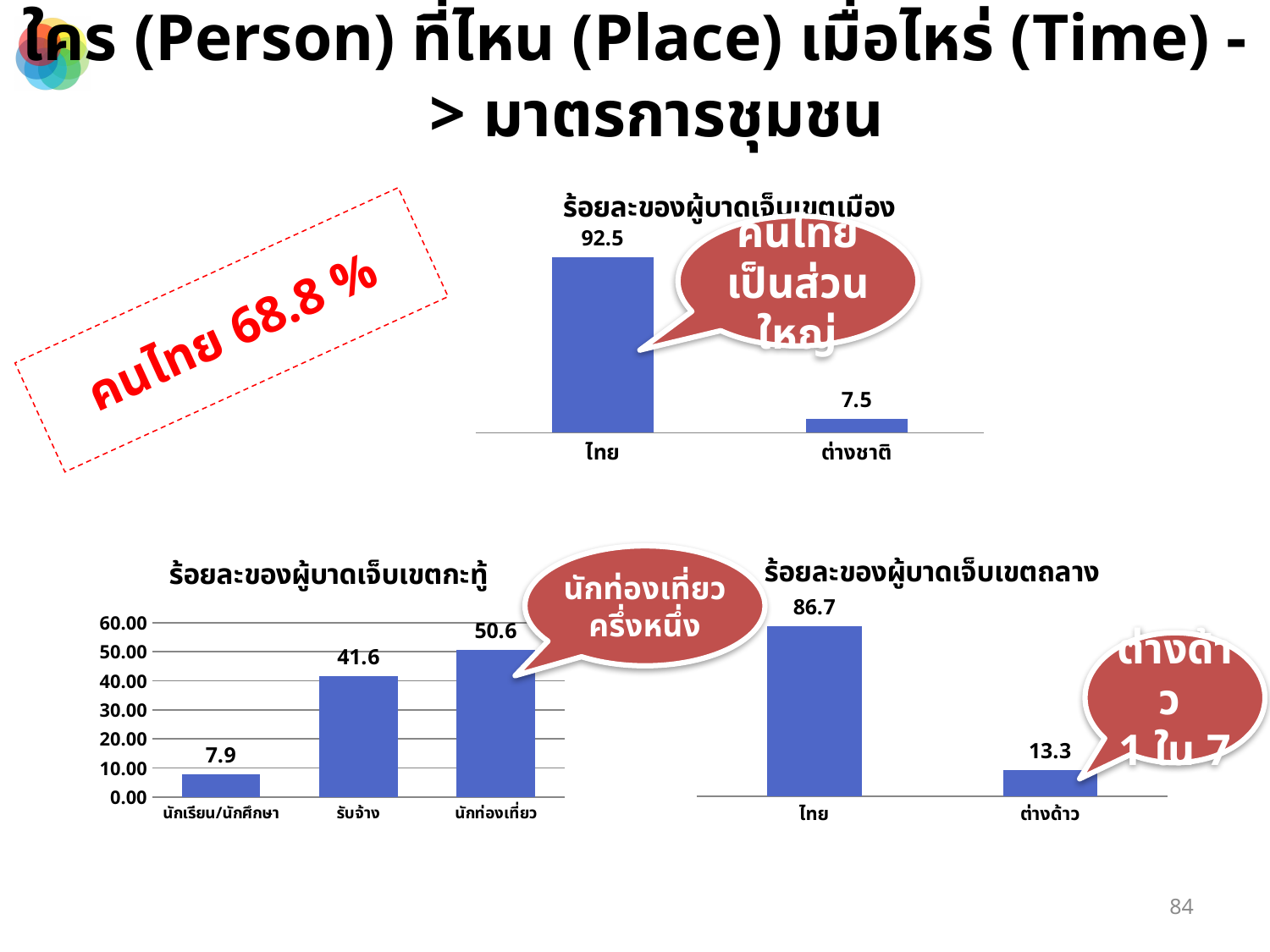
In the top chart (ร้อยละของผู้บาดเจ็บเขตเมือง), what is the value for ไทย? 92.5 In the bottom-left chart (ร้อยละของผู้บาดเจ็บเขตกะทู้), what is the difference between the values for นักท่องเที่ยว and รับจ้าง? 9.0 In the bottom-left chart (ร้อยละของผู้บาดเจ็บเขตกะทู้), which category has the lowest value? นักเรียน/นักศึกษา In the top chart (ร้อยละของผู้บาดเจ็บเขตเมือง), what is the difference between the values for ไทย and ต่างชาติ? 85.0 In the bottom-left chart (ร้อยละของผู้บาดเจ็บเขตกะทู้), what is the value for รับจ้าง? 41.6 In the bottom-right chart (ร้อยละของผู้บาดเจ็บเขตถลาง), which is larger, the value for ไทย or ต่างด้าว? ไทย How many charts are shown on the slide? 3 In the bottom-right chart (ร้อยละของผู้บาดเจ็บเขตถลาง), what is the value for ต่างด้าว? 13.3 What kind of chart is the bottom-right chart (ร้อยละของผู้บาดเจ็บเขตถลาง)? Bar chart In the bottom-left chart (ร้อยละของผู้บาดเจ็บเขตกะทู้), which category has the highest value? นักท่องเที่ยว In the bottom-left chart (ร้อยละของผู้บาดเจ็บเขตกะทู้), how many categories are shown? 3 In the top chart (ร้อยละของผู้บาดเจ็บเขตเมือง), what is the value for ต่างชาติ? 7.5